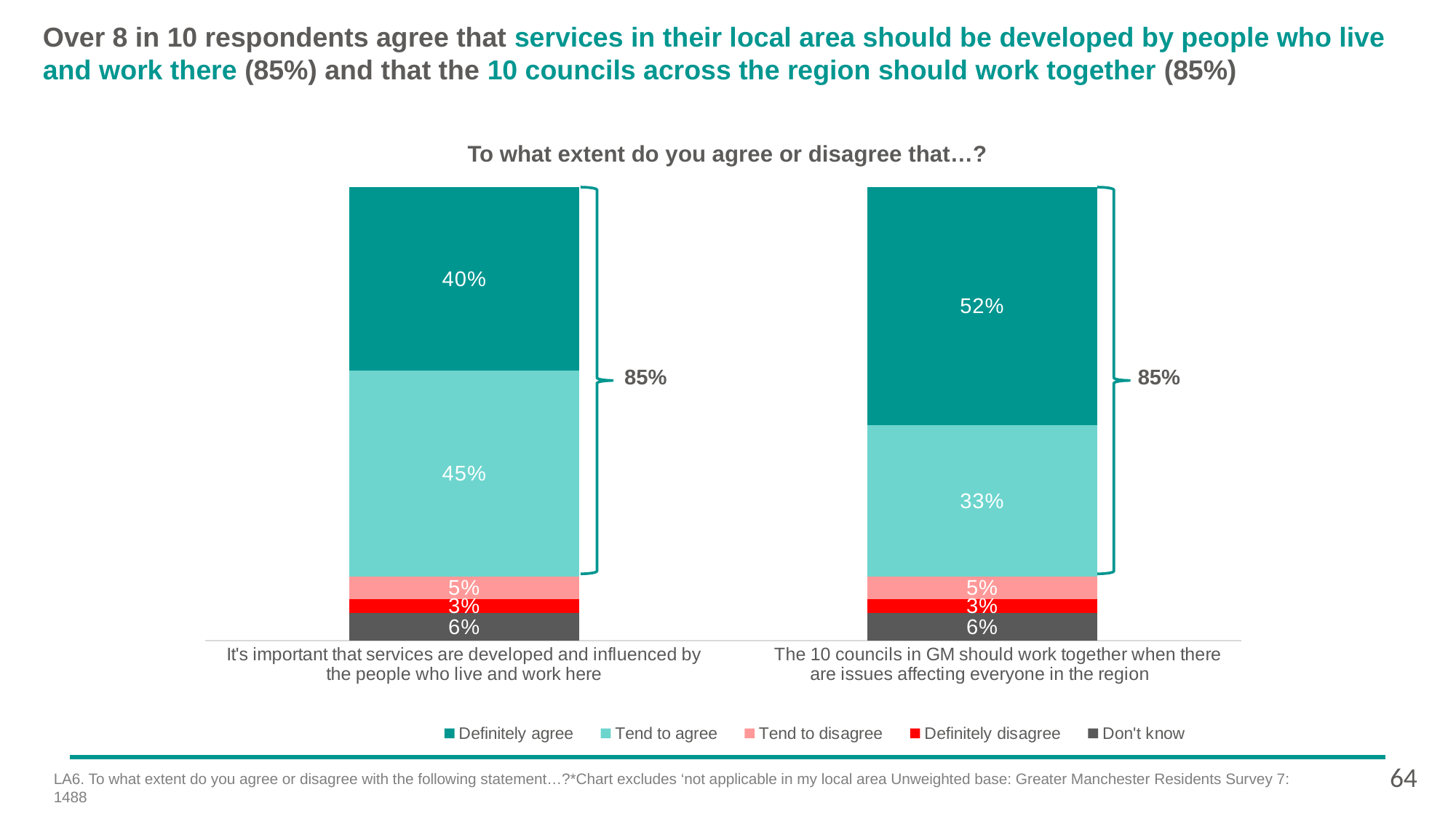
What percentage of respondents 'Definitely agree' that the 10 councils in GM should work together when there are issues affecting everyone in the region? 52% How many series does the legend list? 5 How many statements (categories) are shown on the x axis? 2 What percentage of respondents answered 'Don't know' for the statement about services being developed and influenced by the people who live and work here? 6% What kind of chart is shown on the slide? Stacked bar chart What is the combined 'Definitely agree' and 'Tend to agree' share shown by the bracket for the statement about the 10 councils in GM working together? 85% Which response category has the lowest percentage for the statement about the 10 councils in GM working together? Definitely disagree What is the title of the chart? To what extent do you agree or disagree that…? Which statement has the larger 'Tend to agree' percentage? It's important that services are developed and influenced by the people who live and work here What percentage of respondents 'Definitely agree' that it's important that services are developed and influenced by the people who live and work here? 40% What percentage of respondents 'Tend to agree' that the 10 councils in GM should work together when there are issues affecting everyone in the region? 33% What is the difference between the 'Definitely agree' percentages for the two statements? 12 percentage points